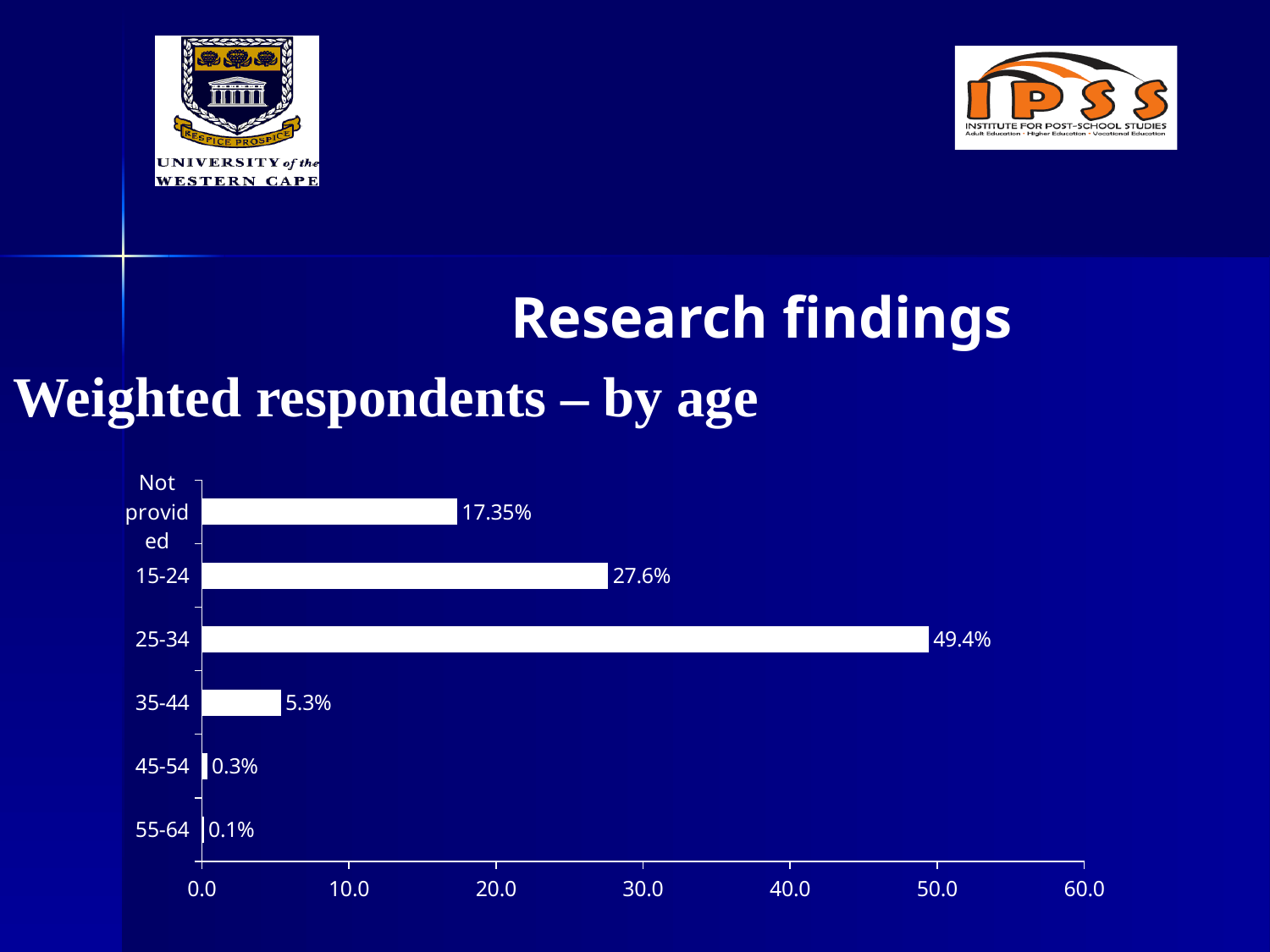
What is the value for the 'Not provided' category? 17.35% What kind of chart is shown on the slide? Bar chart Which age category has the lowest value? 55-64 What is the value for the 35-44 age group? 5.3% Which is larger, the value for 15-24 or the value for 'Not provided'? 15-24 What is the value for the 25-34 age group? 49.4% How many categories are shown on the chart? 6 Which age category has the highest value? 25-34 What is the value for the 15-24 age group? 27.6% What is the difference between the values for 25-34 and 15-24? 21.8% What is the value for the 45-54 age group? 0.3% Is the value for 25-34 greater or less than 40.0? greater